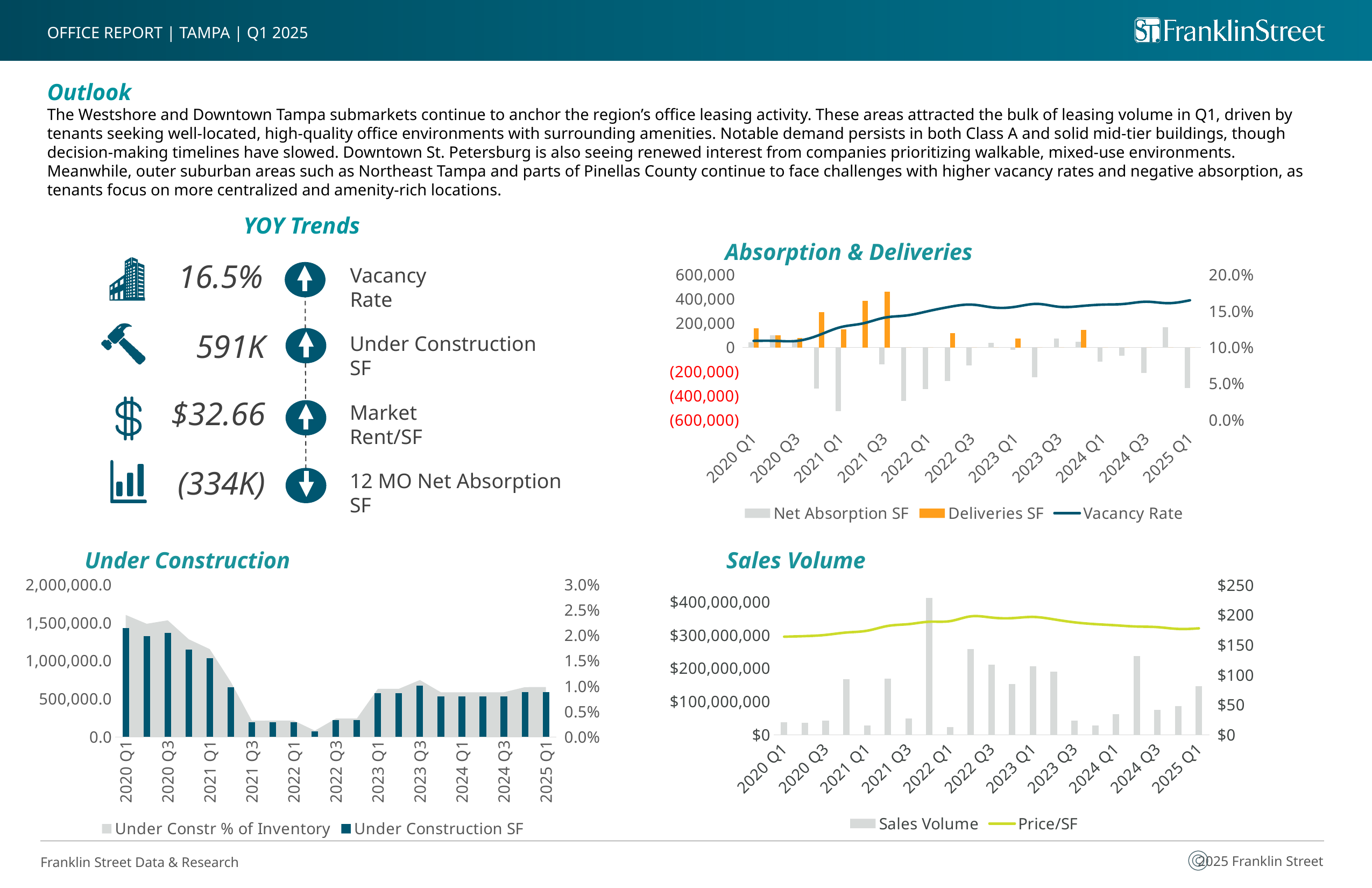
In the Under Construction chart, which quarter has the lowest Under Construction SF bar? 2022 Q2 How many series does the legend of the Absorption & Deliveries chart list? 3 In the Absorption & Deliveries chart, which quarter has the lowest (most negative) Net Absorption SF bar? 2021 Q1 How many quarters are plotted along the x axis of the Under Construction chart? 21 In the Sales Volume chart, which quarter has the highest Sales Volume bar? 2021 Q4 In the Absorption & Deliveries chart, does the Vacancy Rate line generally rise or fall from 2020 Q1 to 2025 Q1? rise In the Sales Volume chart, is the Sales Volume for 2022 Q1 greater or less than $300,000,000? less How many series does the legend of the Under Construction chart list? 2 In the Under Construction chart, which quarter has the highest Under Construction SF bar? 2020 Q1 In the Under Construction chart, is the Under Construction SF value for 2025 Q1 greater or less than 1,000,000.0? less In the Absorption & Deliveries chart, is the Vacancy Rate for 2025 Q1 greater or less than 15.0%? greater In the Absorption & Deliveries chart, which quarter has the highest Deliveries SF bar? 2021 Q3